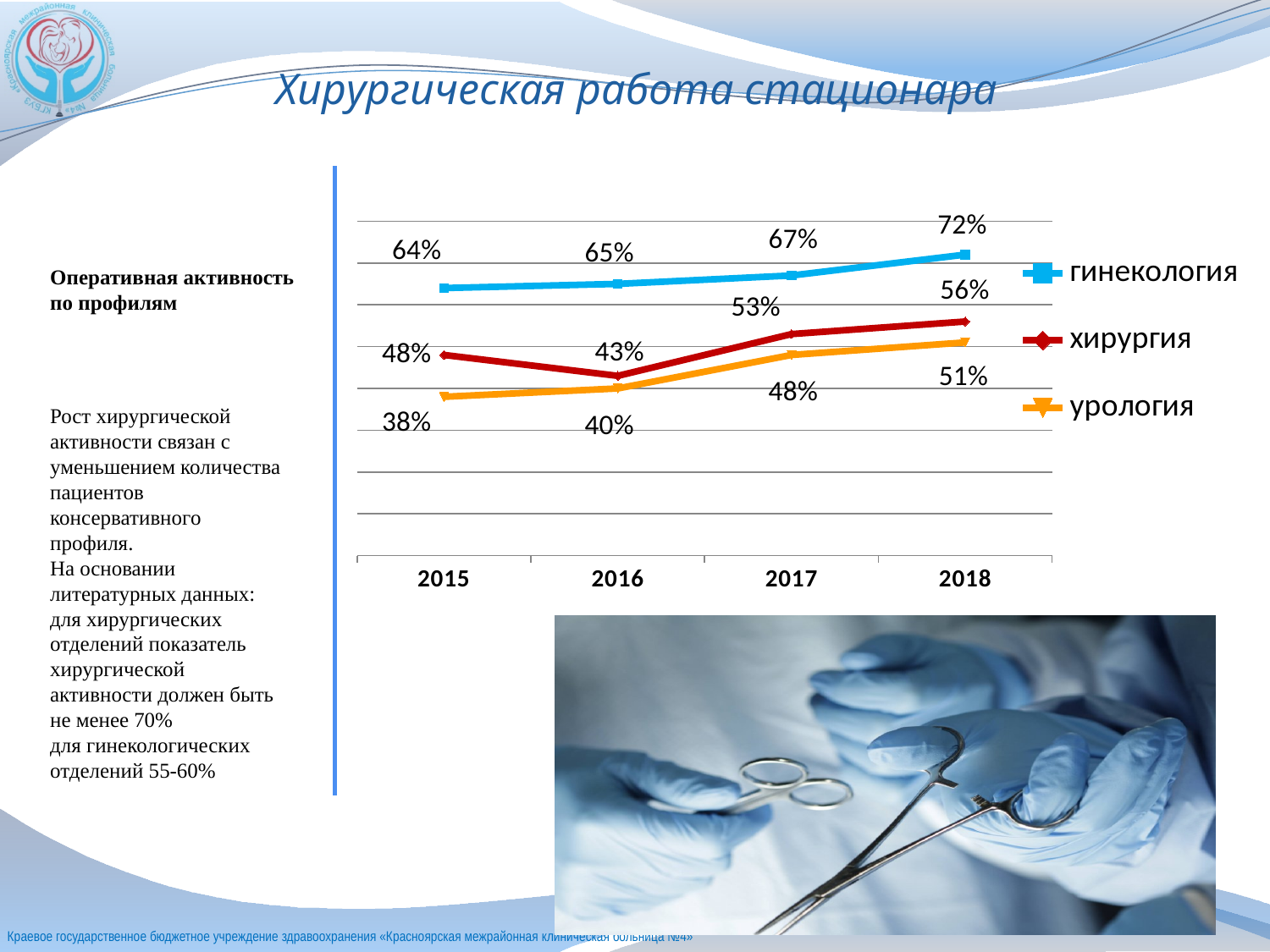
In which year is the value for хирургия lowest? 2016 What is the value for хирургия in 2017? 53% How many series does the legend list? 3 What type of chart is shown on the slide? line chart Which is larger in 2017: the value for хирургия or the value for урология? хирургия How many years are shown on the x axis? 4 What is the value for урология in 2015? 38% What is the value for хирургия in 2016? 43% In which year is the value for урология highest? 2018 Does the value for гинекология rise or fall from 2015 to 2018? rise What is the value for гинекология in 2018? 72% What is the difference between the гинекология values in 2018 and 2015? 8%